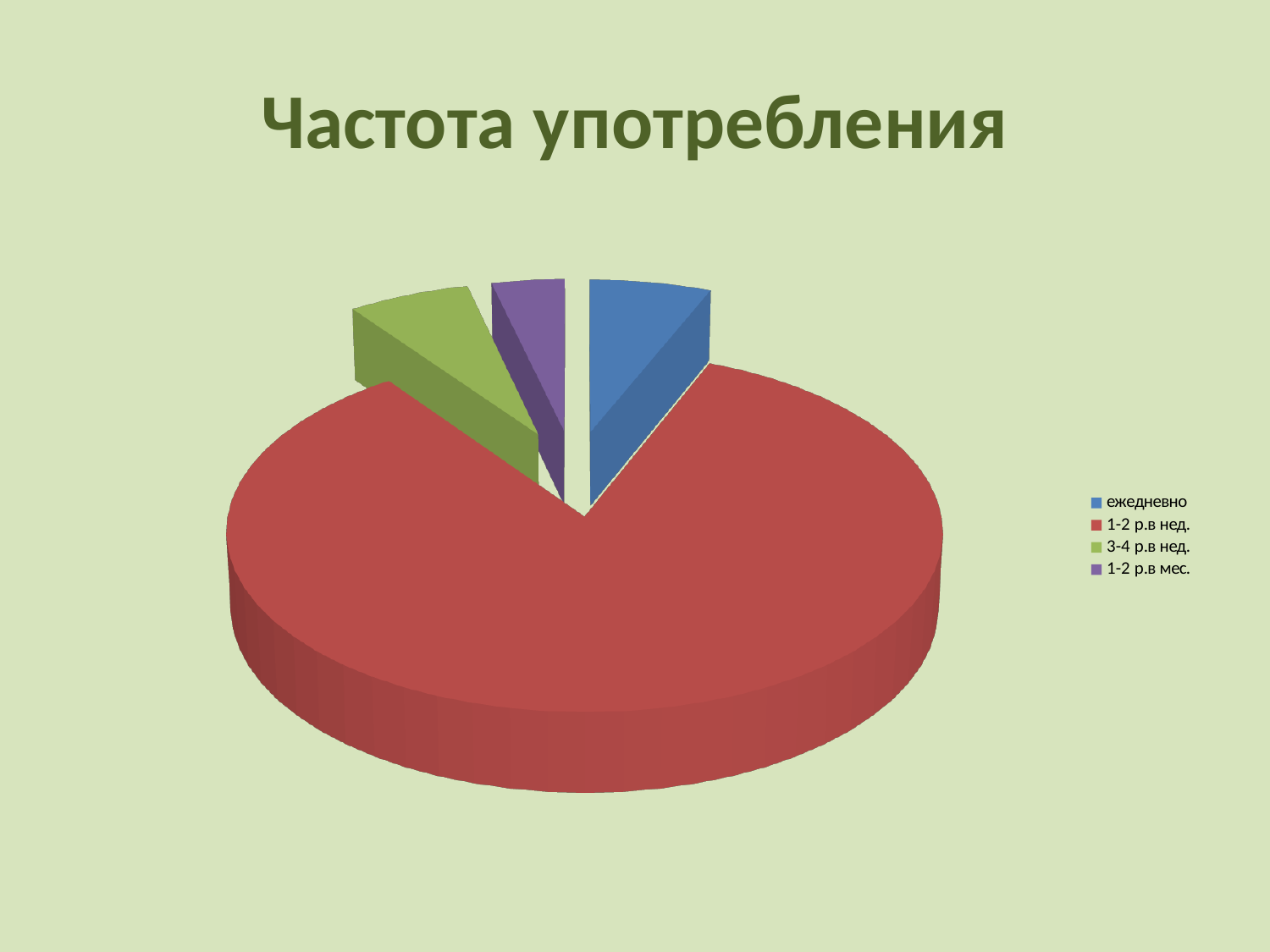
Which category has the smallest slice of the pie? 1-2 р.в мес. Which slice is larger: "ежедневно" or "1-2 р.в мес."? ежедневно What kind of chart is shown on the slide? pie chart Which category has the largest slice of the pie? 1-2 р.в нед. Which slice is larger: "3-4 р.в нед." or "1-2 р.в мес."? 3-4 р.в нед. How many categories does the legend of the pie chart list? 4 What is the title of the chart? Частота употребления Which slice is larger: "ежедневно" or "1-2 р.в нед."? 1-2 р.в нед. What colour is the slice for "1-2 р.в нед."? red